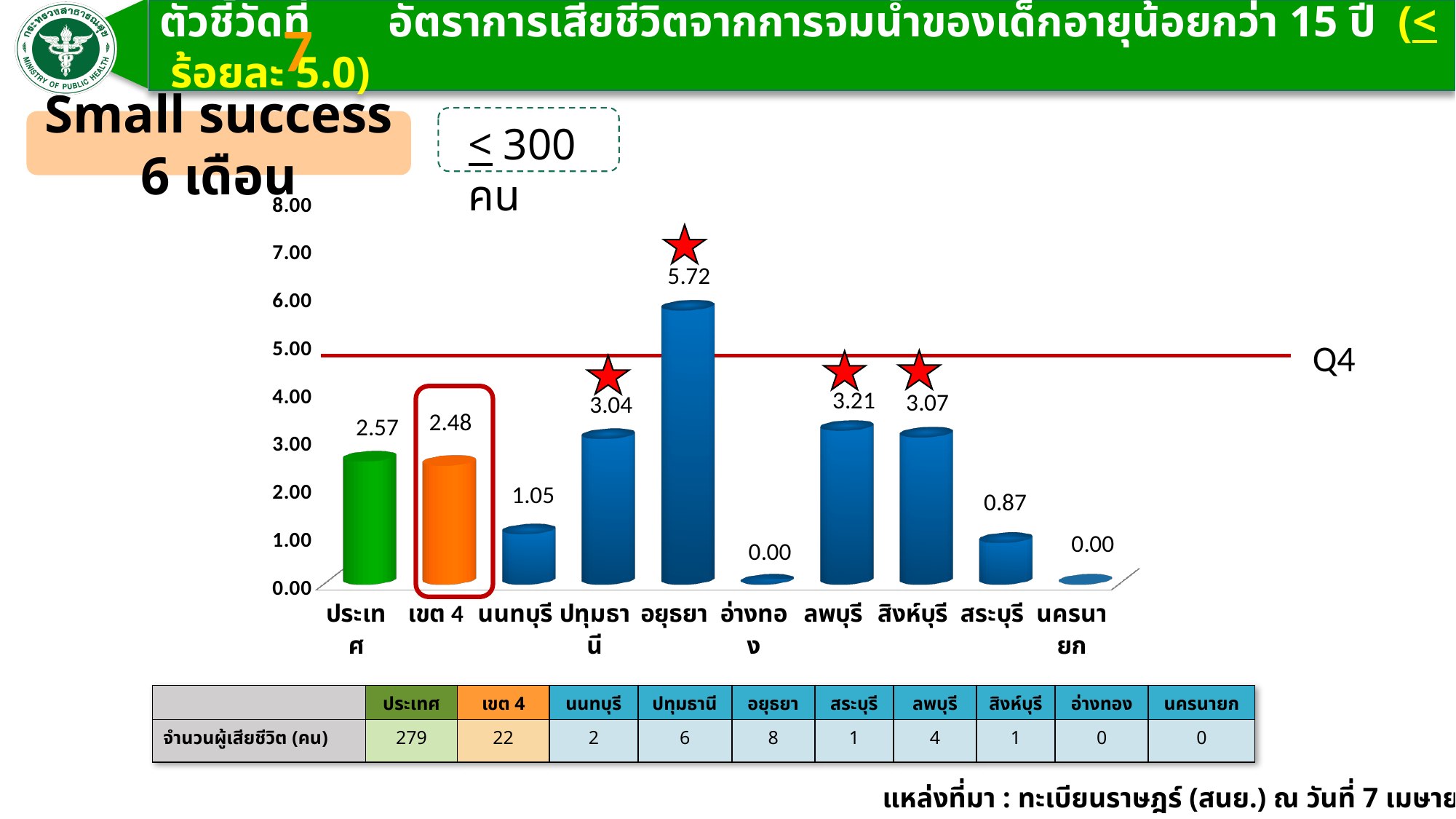
What is the value shown for อยุธยา? 5.72 Which category has the highest value in the chart? อยุธยา Which is larger, the value for ปทุมธานี or the value for นนทบุรี? ปทุมธานี What is the difference between the values for ลพบุรี and สิงห์บุรี? 0.14 What is the value shown for นนทบุรี? 1.05 How many categories are shown on the x axis of the chart? 10 What is the value shown for เขต 4? 2.48 What is the value shown for สระบุรี? 0.87 What is the difference between the values for ประเทศ and เขต 4? 0.09 Is the value for อยุธยา greater or less than 5.00? greater What kind of chart is shown on the slide? bar chart What label is shown next to the red horizontal line on the chart? Q4